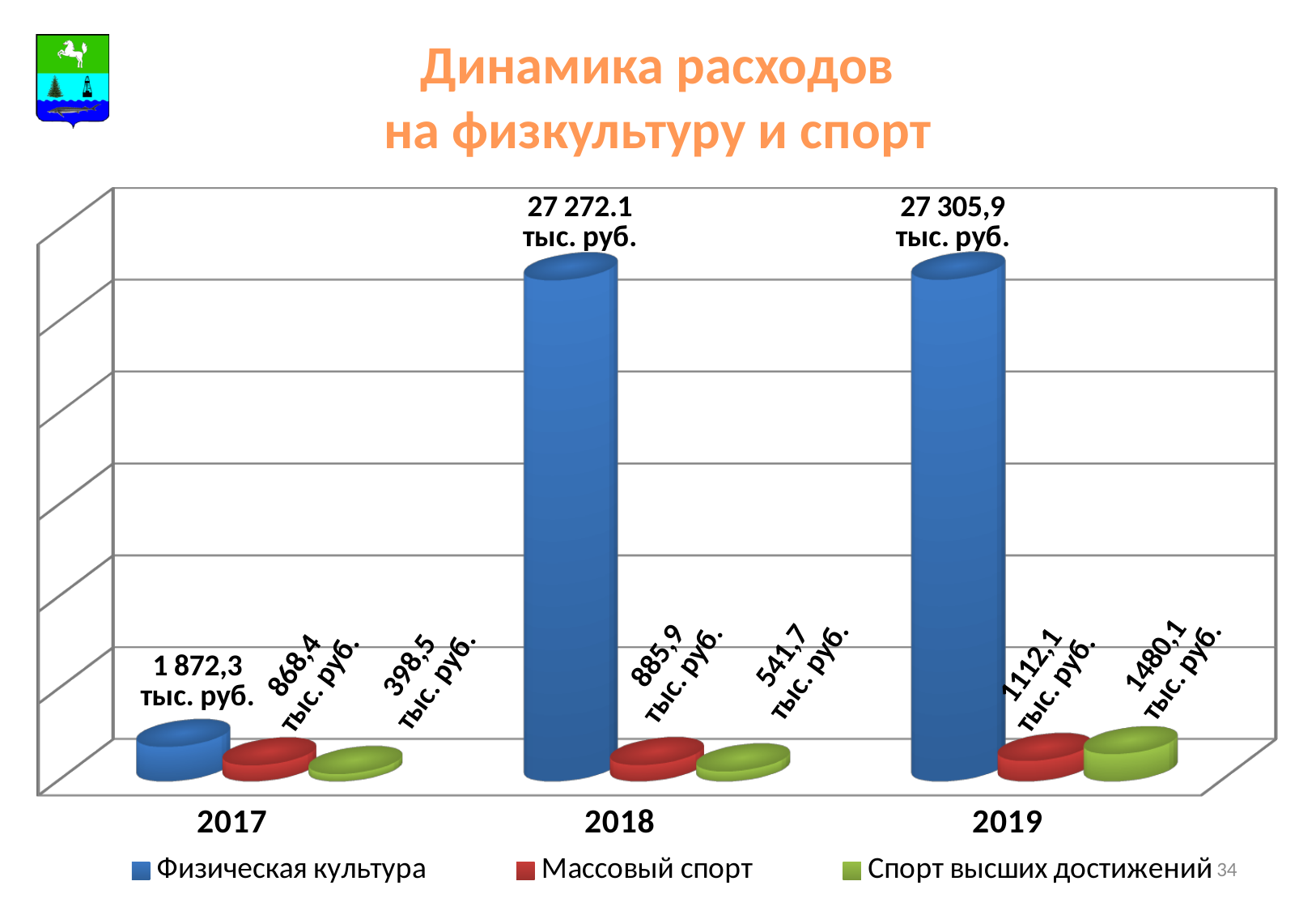
What is the value for Физическая культура in 2017? 1 872,3 тыс. руб. Which series has the lowest value in 2017? Спорт высших достижений What is the value for Массовый спорт in 2017? 868,4 тыс. руб. What is the difference between the Массовый спорт values for 2018 and 2017? 17,5 тыс. руб. How many years are shown on the x axis? 3 In 2019, which is larger: Массовый спорт or Спорт высших достижений? Спорт высших достижений What is the value for Физическая культура in 2018? 27 272.1 тыс. руб. How many series does the legend list? 3 In which year is the value for Физическая культура the highest? 2019 What kind of chart is shown on the slide? Bar chart What is the value for Спорт высших достижений in 2019? 1480,1 тыс. руб. Does the value for Спорт высших достижений rise or fall from 2017 to 2019? Rise